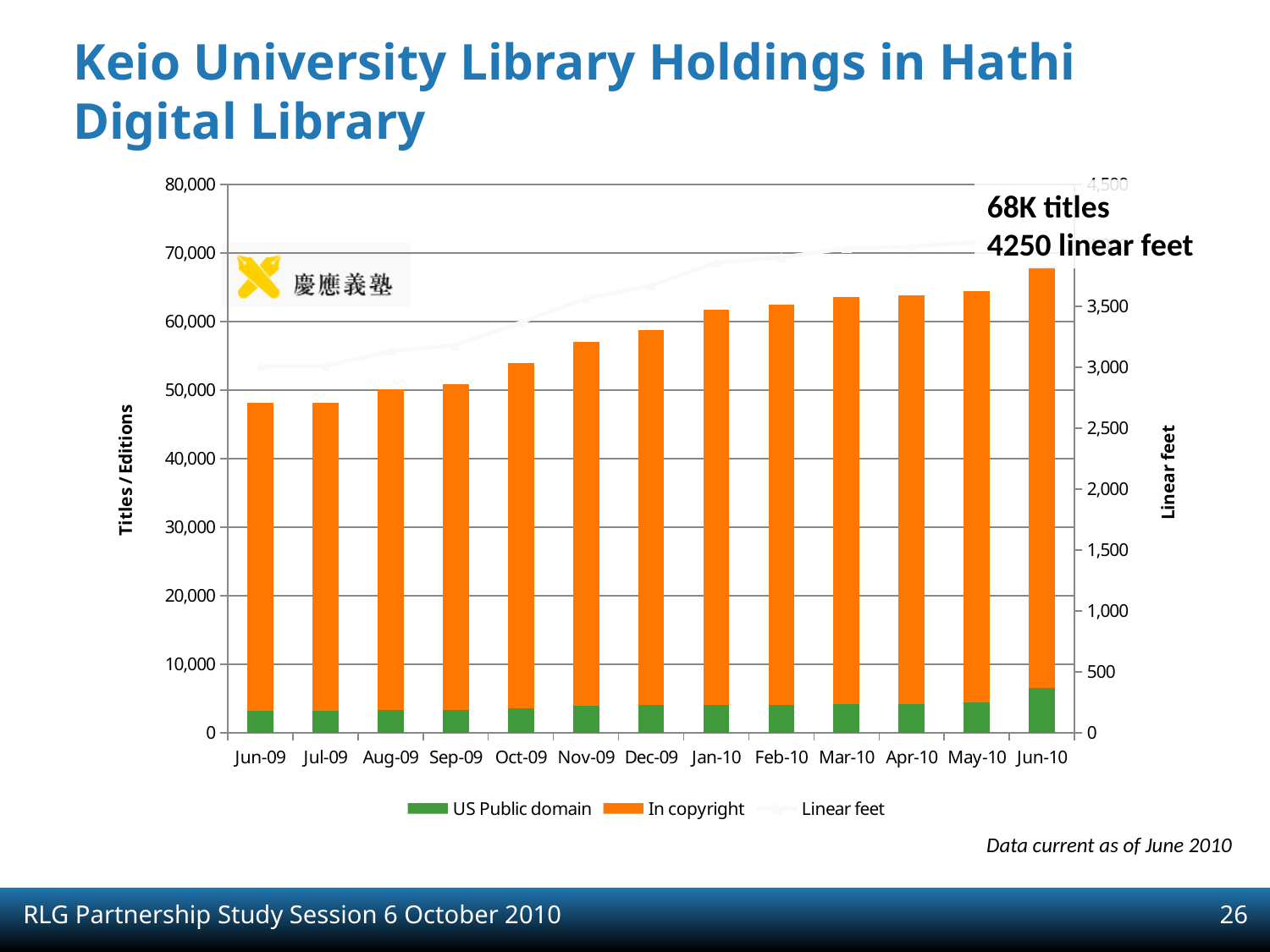
Is the total stacked bar for Jun-09 greater or less than 40,000? greater Which month has the tallest stacked bar? Jun-10 What is the title of the left vertical axis? Titles / Editions What kind of chart is used to show the US Public domain and In copyright series? bar chart How many months are shown along the x axis? 13 Is the total stacked bar for Jun-10 greater or less than 60,000? greater Is the total stacked bar for Nov-09 greater or less than 60,000? less Do the stacked bar totals rise or fall from Jun-09 to Jun-10? rise How many series does the legend list? 3 According to the annotation on the chart, how many linear feet are reported for the latest month? 4250 linear feet Which has the larger stacked bar total, Jun-09 or Jun-10? Jun-10